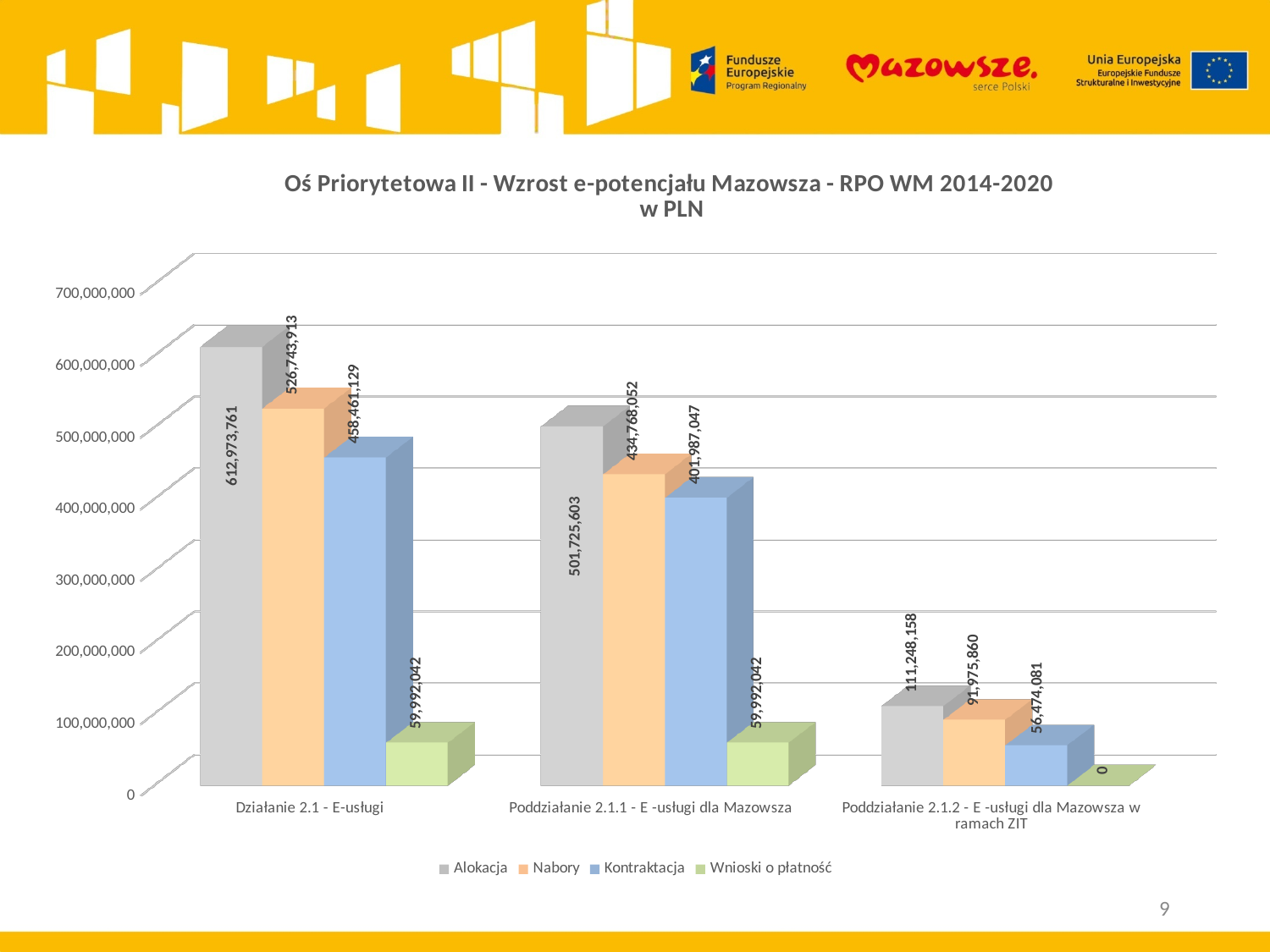
How many series does the legend list? 4 What type of chart is shown on the slide? Bar chart Which is larger for Poddziałanie 2.1.1 - E -usługi dla Mazowsza: Nabory or Kontraktacja? Nabory What is the difference between the Alokacja values for Działanie 2.1 - E-usługi and Poddziałanie 2.1.1 - E -usługi dla Mazowsza? 111,248,158 What is the Nabory value for Poddziałanie 2.1.2 - E -usługi dla Mazowsza w ramach ZIT? 91,975,860 What is the Alokacja value for Działanie 2.1 - E-usługi? 612,973,761 Is the Alokacja value for Poddziałanie 2.1.1 - E -usługi dla Mazowsza greater or less than 500,000,000? greater What is the Kontraktacja value for Poddziałanie 2.1.1 - E -usługi dla Mazowsza? 401,987,047 Which category has the lowest Kontraktacja value? Poddziałanie 2.1.2 - E -usługi dla Mazowsza w ramach ZIT Which category has the highest Alokacja value? Działanie 2.1 - E-usługi How many categories are shown on the x axis? 3 What is the Wnioski o płatność value for Poddziałanie 2.1.2 - E -usługi dla Mazowsza w ramach ZIT? 0